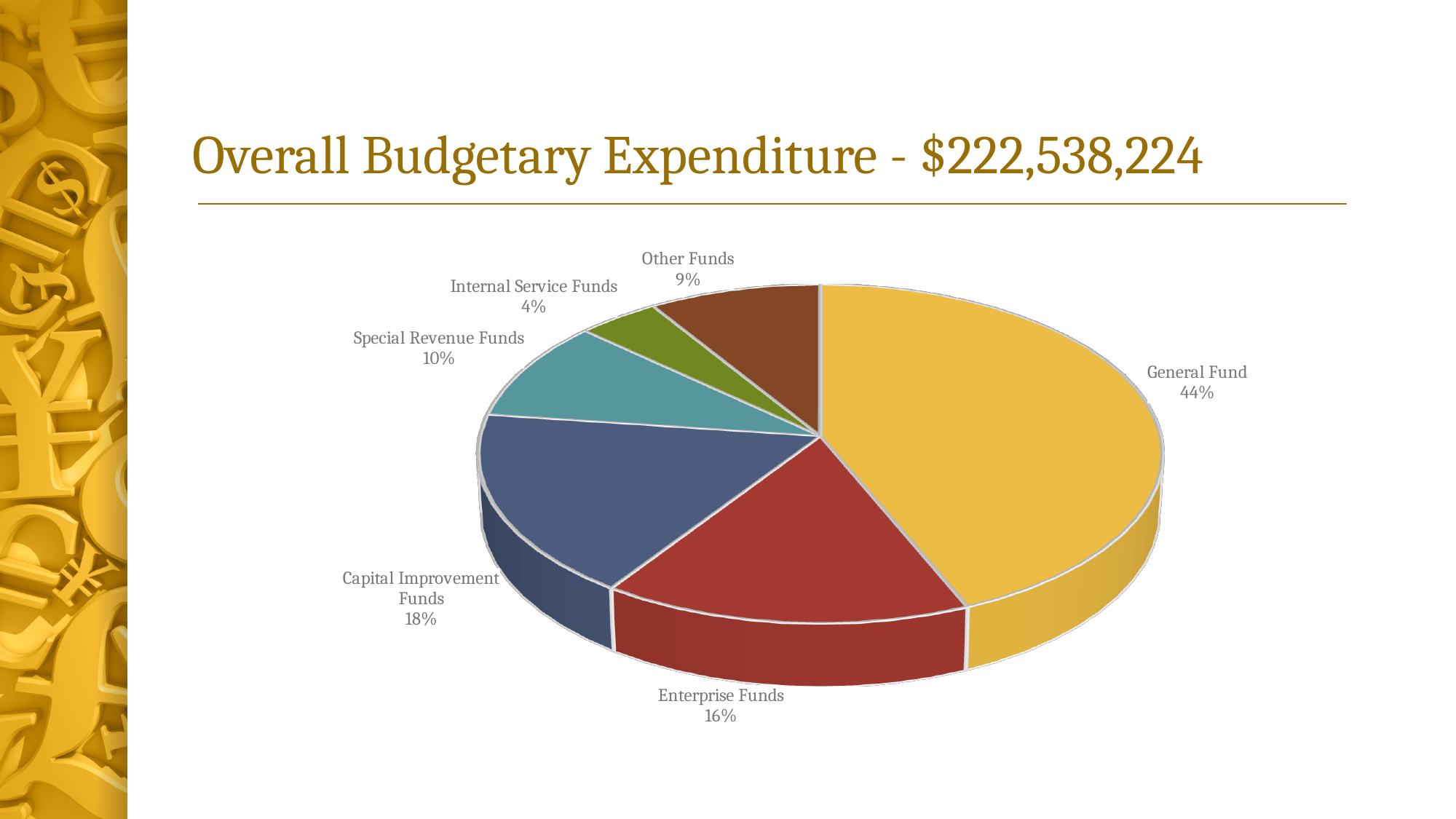
How many fund categories are shown in the pie chart? 6 What is the difference in percentage points between the General Fund and Capital Improvement Funds? 26 Which fund category has the largest share of the pie? General Fund What percentage is shown for Enterprise Funds? 16% What percentage is shown for Capital Improvement Funds? 18% What type of chart is shown on the slide? Pie chart What percentage is shown for Other Funds? 9% What percentage is shown for Special Revenue Funds? 10% Which fund category has the smallest share of the pie? Internal Service Funds What share of the overall budgetary expenditure is the General Fund? 44% What percentage is shown for Internal Service Funds? 4% Which is larger, Capital Improvement Funds or Enterprise Funds? Capital Improvement Funds